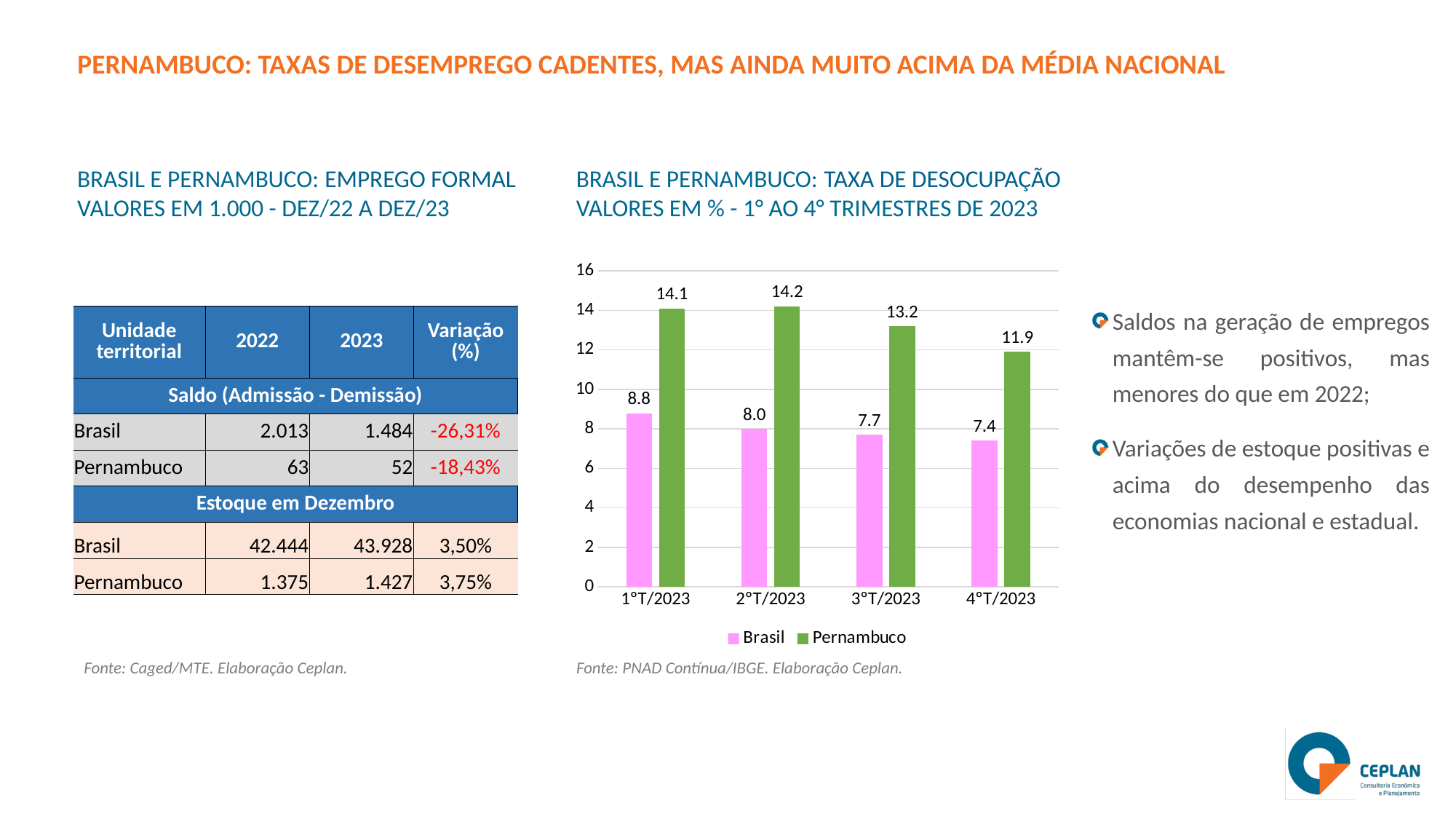
What is the value for Brasil in 2°T/2023? 8.0 What is the difference between the Pernambuco and Brasil values in 3°T/2023? 5.5 What is the value for Pernambuco in 1°T/2023? 14.1 How many series does the chart legend list? 2 In which quarter is the Brasil value lowest? 4°T/2023 What is the value for Brasil in 4°T/2023? 7.4 Which is larger in 4°T/2023, the Brasil value or the Pernambuco value? Pernambuco Is the value for Pernambuco in 4°T/2023 greater or less than 10? greater How many quarters are shown on the x axis of the chart? 4 Do the Brasil values rise or fall from 1°T/2023 to 4°T/2023? Fall In which quarter is the Pernambuco value highest? 2°T/2023 What kind of chart is shown on the slide? Bar chart